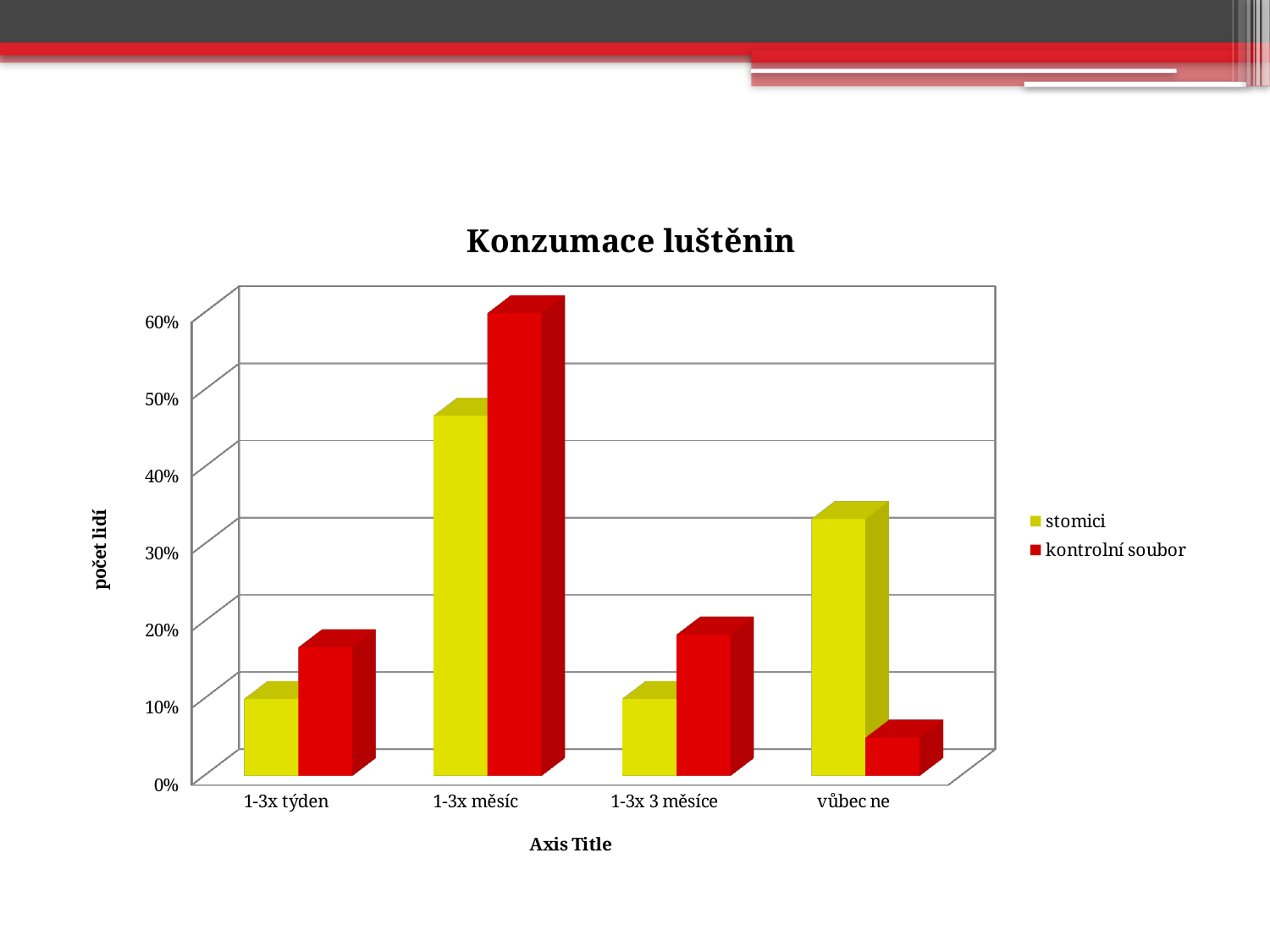
Is the value for stomici in the category 1-3x měsíc greater or less than 40%? greater For the category 1-3x měsíc, which series has the larger value, stomici or kontrolní soubor? kontrolní soubor What kind of chart is shown on the slide? bar chart Which category has the highest value for the stomici series? 1-3x měsíc What is the label of the vertical axis? počet lidí What is the title of the chart? Konzumace luštěnin How many series does the legend list? 2 Is the value for kontrolní soubor in the category vůbec ne greater or less than 10%? less Which category has the highest value for the kontrolní soubor series? 1-3x měsíc For the category vůbec ne, which series has the larger value, stomici or kontrolní soubor? stomici Which category has the lowest value for the kontrolní soubor series? vůbec ne How many categories are shown on the x axis? 4